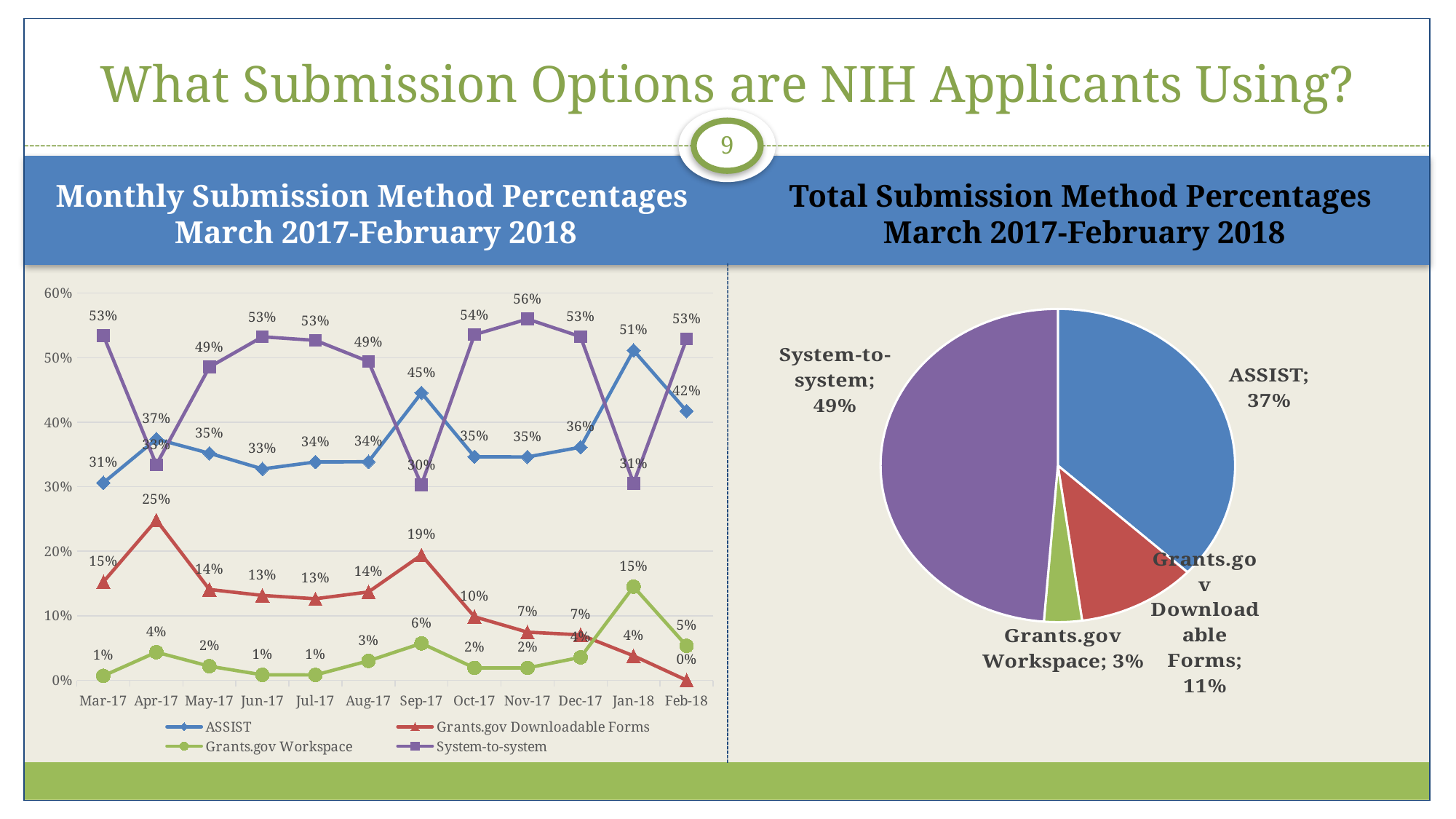
In the 'Monthly Submission Method Percentages' chart, what is the System-to-system value for Nov-17? 56% How many series does the legend of the 'Monthly Submission Method Percentages March 2017-February 2018' chart list? 4 In the 'Monthly Submission Method Percentages' chart, what is the ASSIST value for Jan-18? 51% What kind of chart is the 'Monthly Submission Method Percentages March 2017-February 2018' chart? Line chart In the pie chart titled 'Total Submission Method Percentages March 2017-February 2018', how many percentage points larger is the System-to-system share than the ASSIST share? 12 percentage points In the 'Monthly Submission Method Percentages' chart, by how many percentage points did Grants.gov Downloadable Forms rise from Mar-17 to Apr-17? 10 percentage points How many months are plotted along the x axis of the 'Monthly Submission Method Percentages March 2017-February 2018' chart? 12 In the pie chart titled 'Total Submission Method Percentages March 2017-February 2018', which submission method has the smallest slice? Grants.gov Workspace In the 'Monthly Submission Method Percentages' chart, which was higher in Sep-17: ASSIST or System-to-system? ASSIST In the pie chart titled 'Total Submission Method Percentages March 2017-February 2018', what share does ASSIST have? 37% In the pie chart titled 'Total Submission Method Percentages March 2017-February 2018', which submission method has the largest slice? System-to-system In the 'Monthly Submission Method Percentages' chart, in which month does Grants.gov Workspace reach its highest value? Jan-18